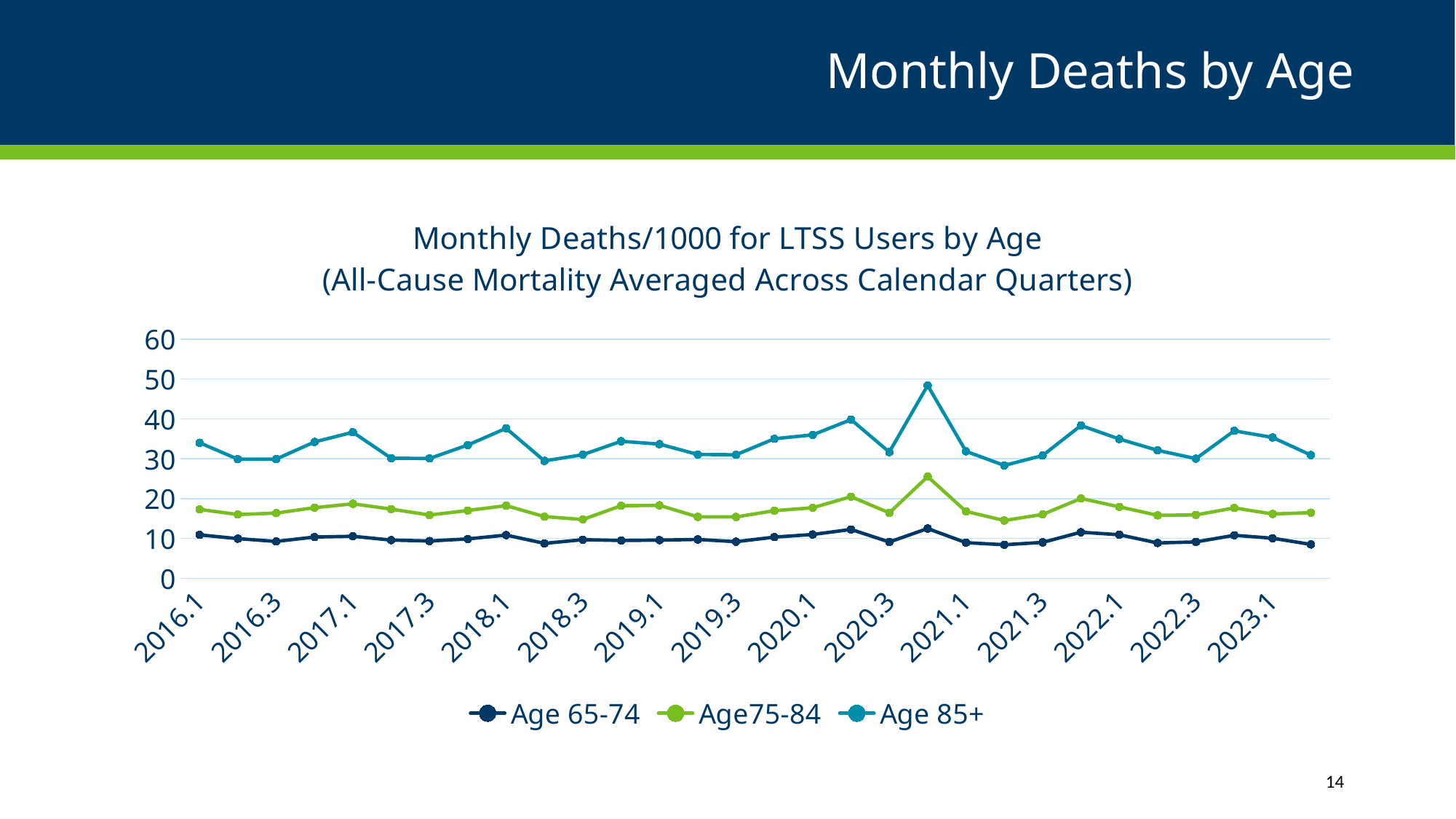
Is the value for Age 85+ at 2021.1 greater or less than 40? less How many series does the legend list? 3 What are the three series named in the legend? Age 65-74, Age75-84, Age 85+ What kind of chart is shown on the slide? Line chart Which age group has the highest monthly deaths per 1000 across the whole period? Age 85+ Is the peak value of the Age 85+ line (between 2020.3 and 2021.1) greater or less than 40? greater What is the first line of the chart's title? Monthly Deaths/1000 for LTSS Users by Age Is the value for Age 85+ at 2016.1 greater or less than 30? greater Which age group has the lowest monthly deaths per 1000 across the whole period? Age 65-74 At 2020.1, which is larger: the value for Age 85+ or the value for Age 65-74? Age 85+